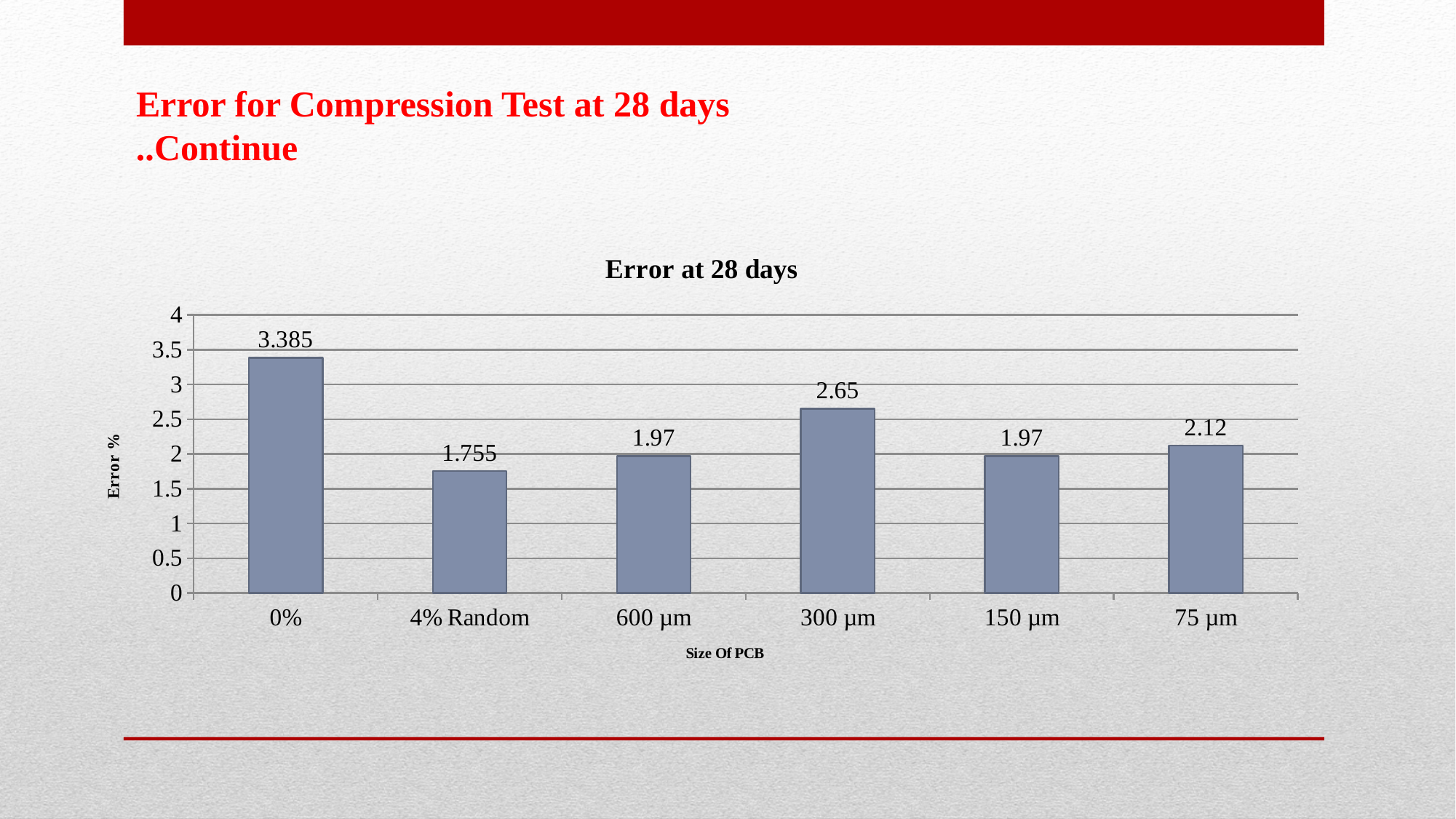
What is the error value for 75 µm? 2.12 Which size of PCB has the highest error? 0% What is the error value for 4% Random? 1.755 What is the error value for 300 µm? 2.65 How many sizes of PCB are shown on the x axis? 6 What is the label of the y axis? Error % What is the error value for 0%? 3.385 What is the title of the chart? Error at 28 days Which has a larger error, 75 µm or 150 µm? 75 µm Which size of PCB has the lowest error? 4% Random What kind of chart is shown on the slide? Bar chart What is the difference between the error for 0% and the error for 300 µm? 0.735